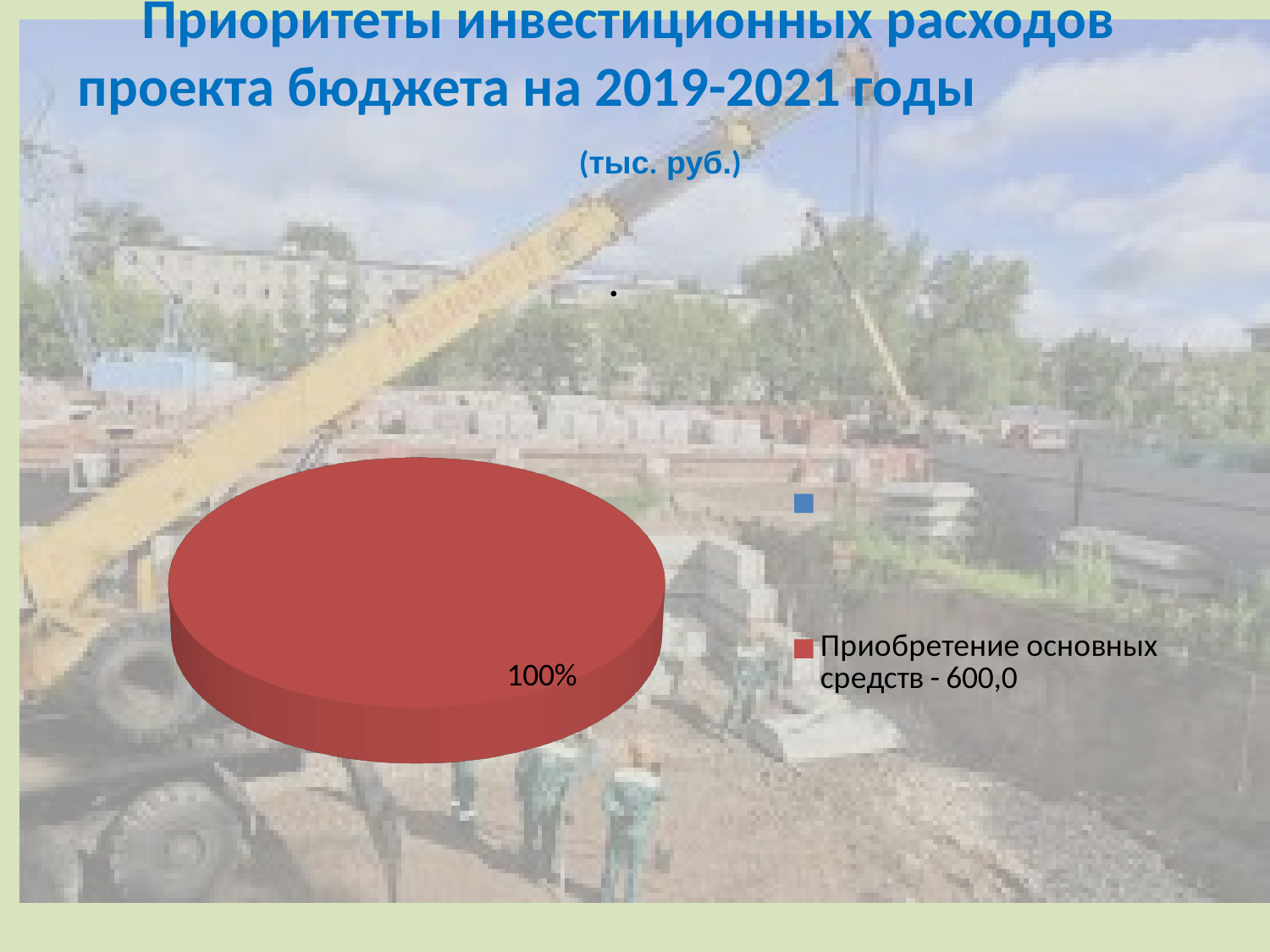
What kind of chart is shown on the slide? pie chart What unit is stated under the chart title? тыс. руб. What percentage label is printed next to the pie slice? 100% What value is given in the legend for "Приобретение основных средств"? 600,0 What colour is the slice for "Приобретение основных средств"? red How many slices are visible in the pie chart? 1 What share of the pie does the slice labelled "Приобретение основных средств" take? 100%